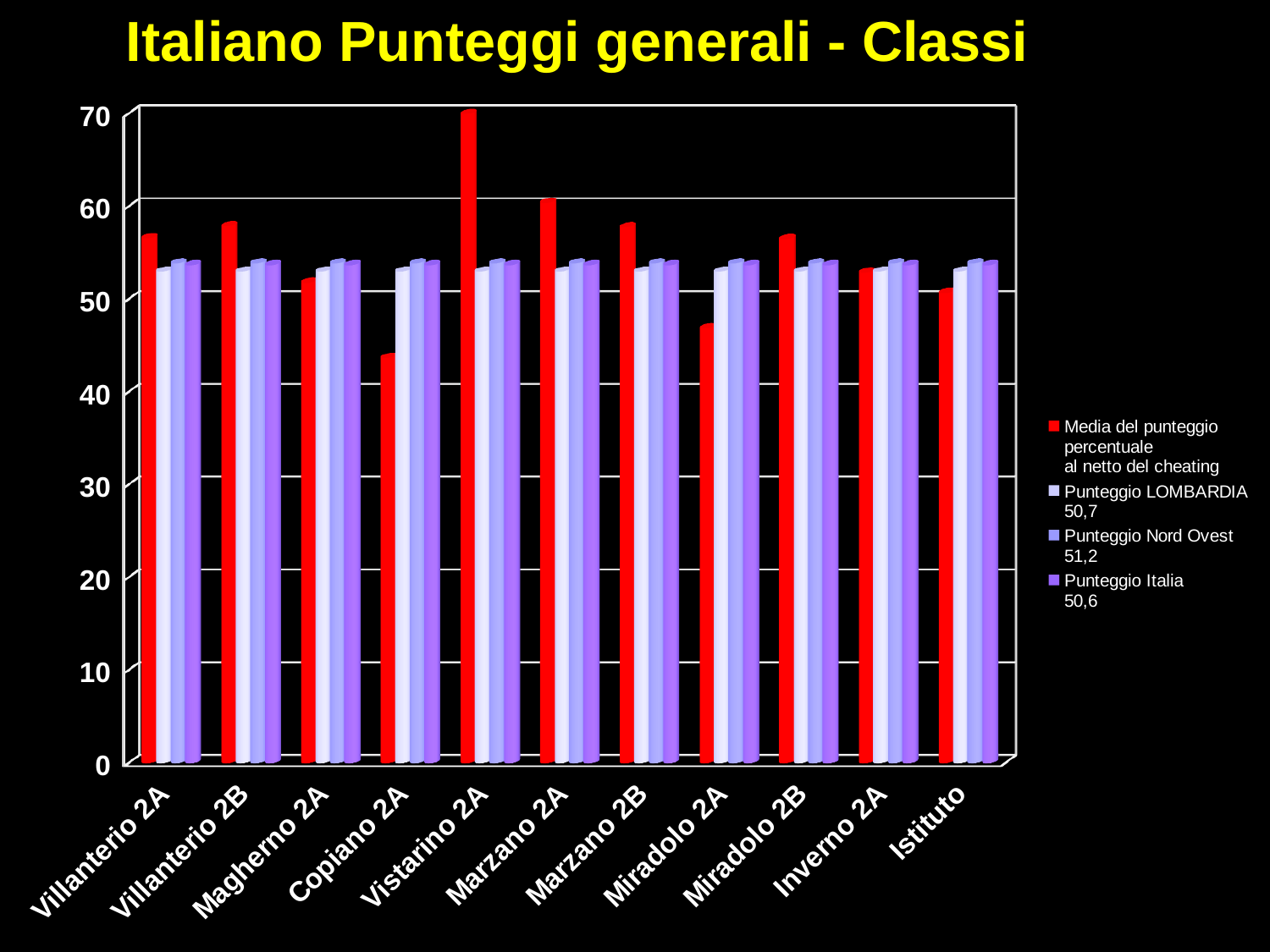
What is the title of the chart? Italiano Punteggi generali - Classi Is the red bar for Vistarino 2A greater or less than 60? greater What type of chart is shown on the slide? bar chart Which has the larger red bar, Vistarino 2A or Copiano 2A? Vistarino 2A Is the red bar for Miradolo 2A greater or less than 50? less Which class has the lowest red bar (Media del punteggio percentuale al netto del cheating)? Copiano 2A Is the red bar for Villanterio 2B greater or less than 50? greater What value does the legend give for Punteggio Nord Ovest? 51,2 How many series does the legend list? 4 How many classes (categories) are shown on the x axis? 11 Which class has the highest red bar (Media del punteggio percentuale al netto del cheating)? Vistarino 2A